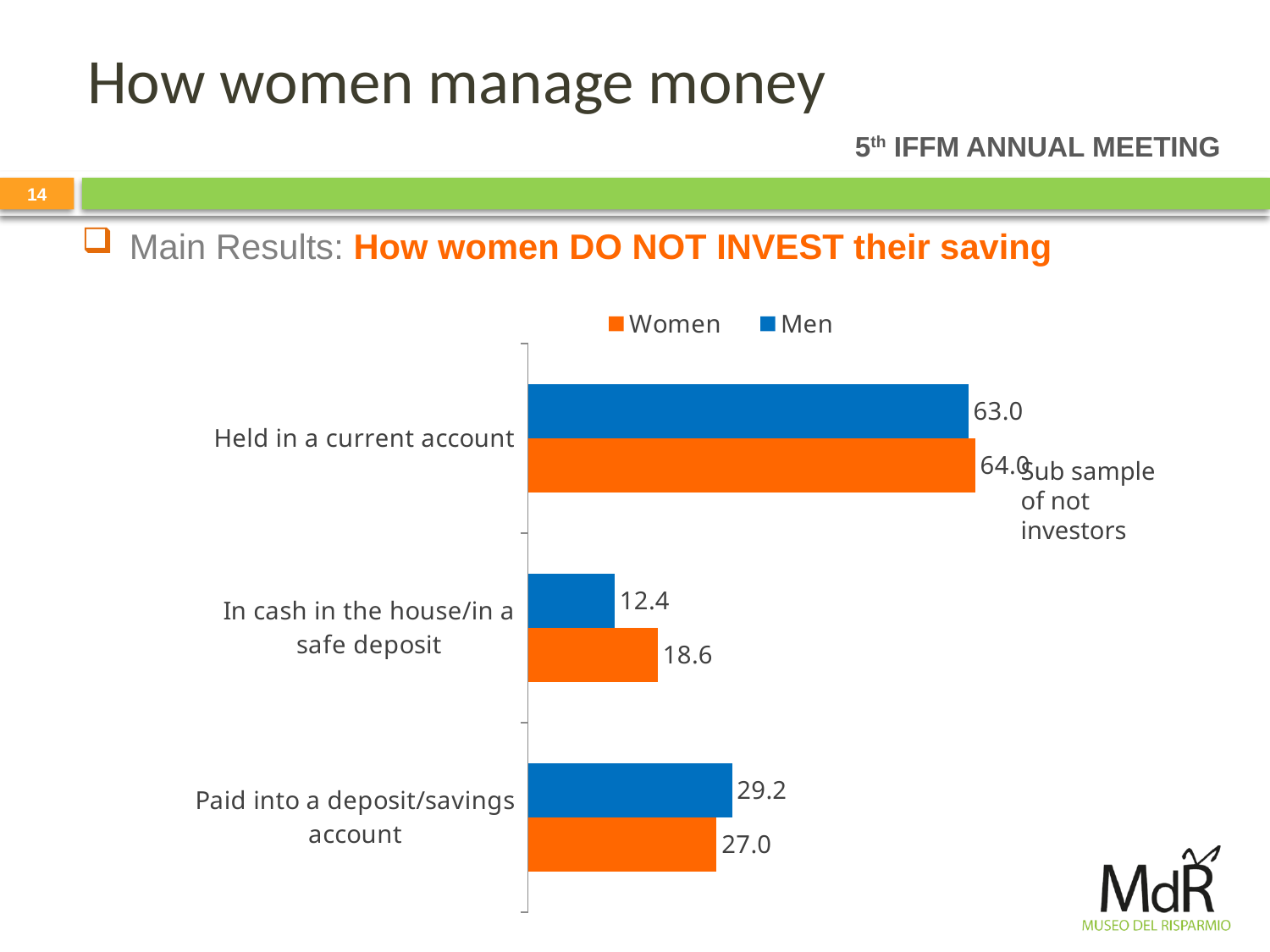
How many categories are shown in the chart? 3 Which category has the highest value for Men? Held in a current account Which category has the lowest value for Women? In cash in the house/in a safe deposit What kind of chart is shown on the slide? bar chart What is the value for Men for 'In cash in the house/in a safe deposit'? 12.4 What is the value for Men for 'Paid into a deposit/savings account'? 29.2 Which is larger for 'Paid into a deposit/savings account', the Women value or the Men value? Men What is the value for Women for 'Paid into a deposit/savings account'? 27.0 What is the difference between the Women and Men values for 'In cash in the house/in a safe deposit'? 6.2 How many series does the legend list? 2 What is the value for Men for 'Held in a current account'? 63.0 What is the value for Women for 'In cash in the house/in a safe deposit'? 18.6